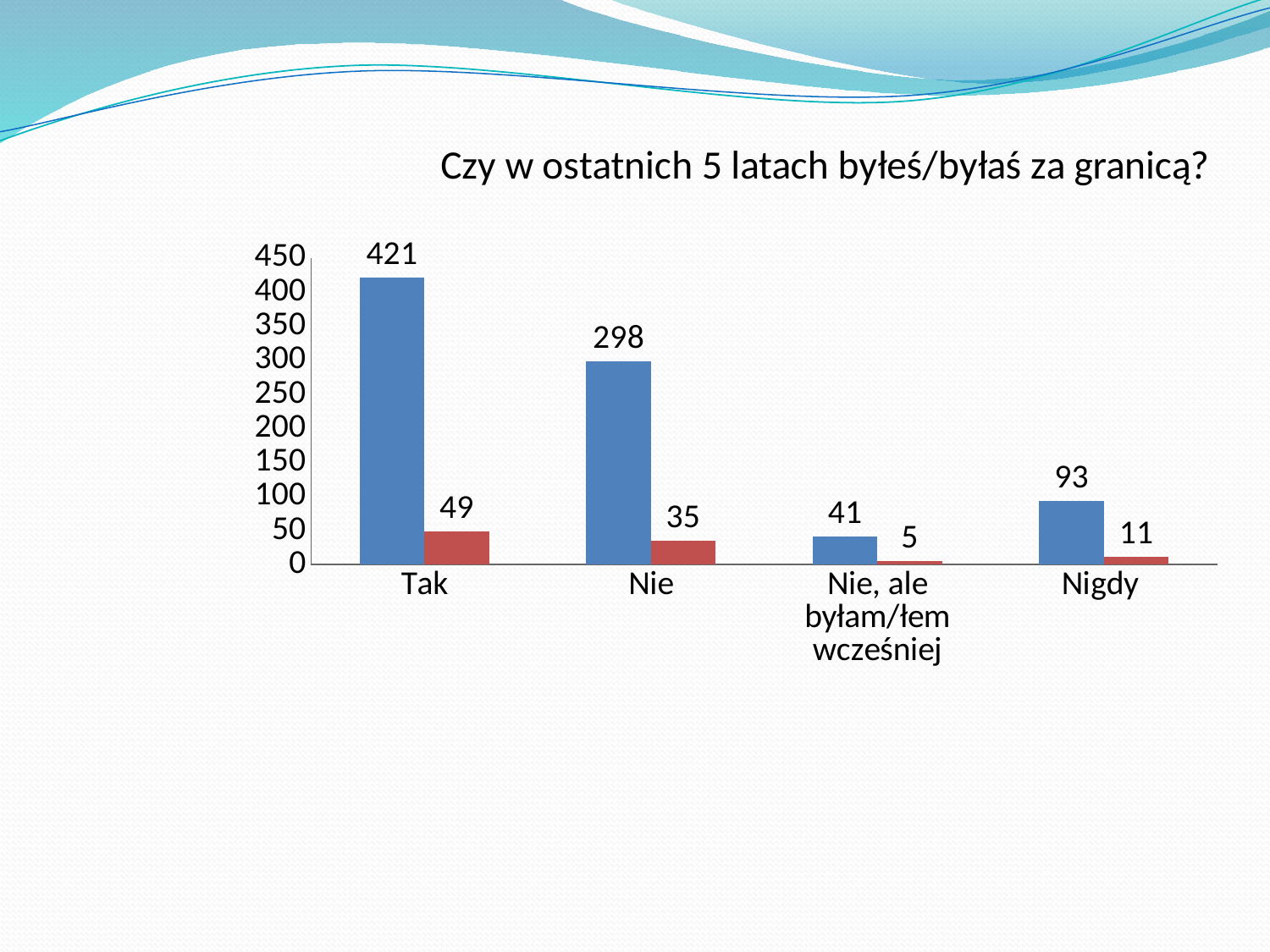
What is the value of the blue bar for "Tak"? 421 What is the difference between the red bars for "Tak" and "Nigdy"? 38 Which category has the highest blue bar? Tak What type of chart is shown on the slide? Bar chart How many categories are shown on the x axis? 4 What is the title of the chart? Czy w ostatnich 5 latach byłeś/byłaś za granicą? What is the difference between the blue bars for "Tak" and "Nie"? 123 What is the value of the red bar for "Nie"? 35 What is the value of the red bar for "Nie, ale byłam/łem wcześniej"? 5 What is the value of the blue bar for "Nigdy"? 93 Which is larger: the blue bar for "Nigdy" or the blue bar for "Nie, ale byłam/łem wcześniej"? Nigdy Which category has the lowest red bar? Nie, ale byłam/łem wcześniej